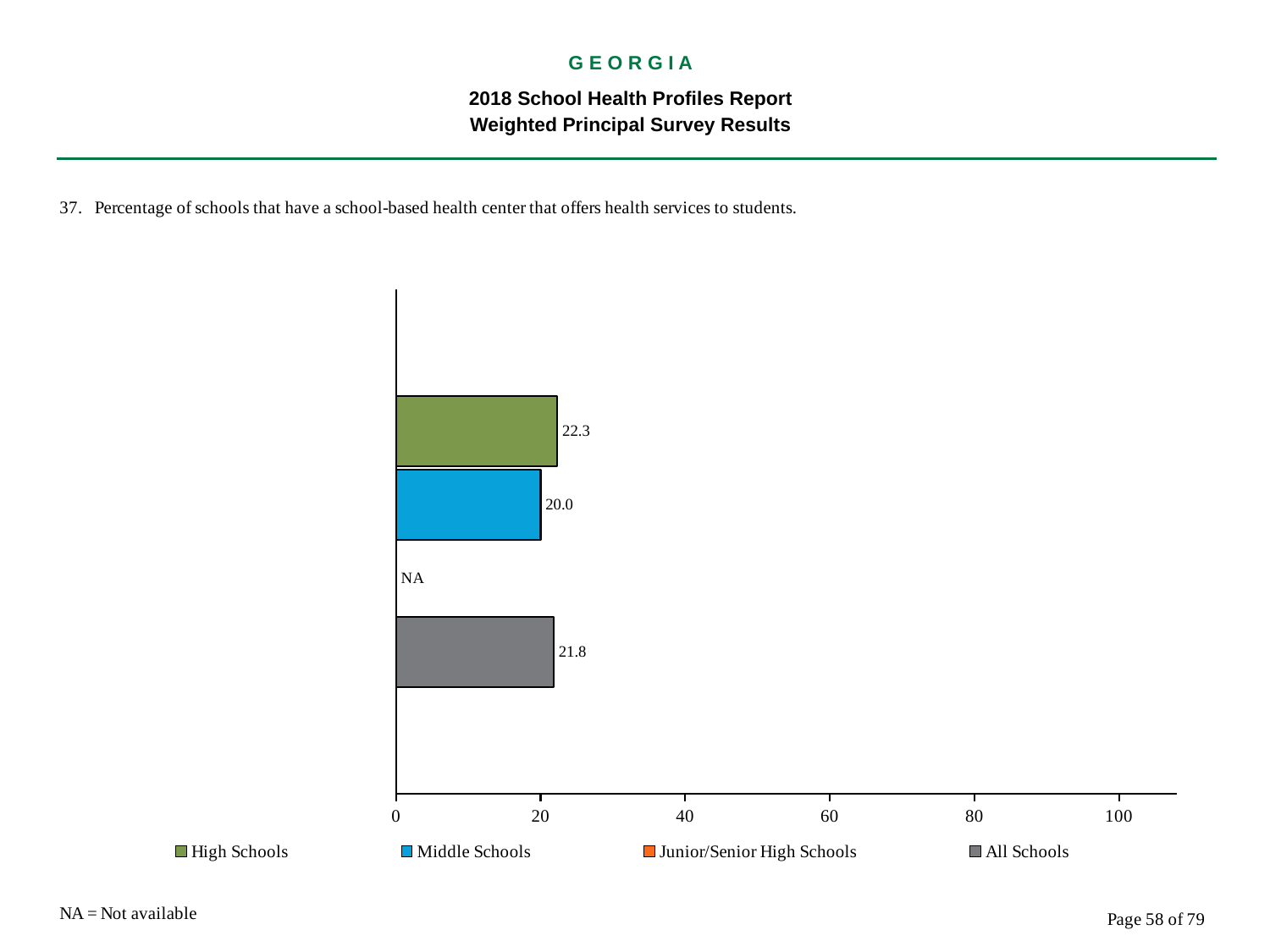
What is the difference between the High Schools value and the Middle Schools value? 2.3 Among the school types with a plotted value, which has the lowest value? Middle Schools What is shown for Junior/Senior High Schools? NA What is the value for High Schools? 22.3 What is the value for Middle Schools? 20.0 What kind of chart is this? bar chart Which is larger, the value for All Schools or the value for Middle Schools? All Schools Which school type has the highest value? High Schools What does NA stand for according to the note on the slide? Not available How many series does the legend list? 4 Is the value for High Schools greater or less than 40? less What is the value for All Schools? 21.8